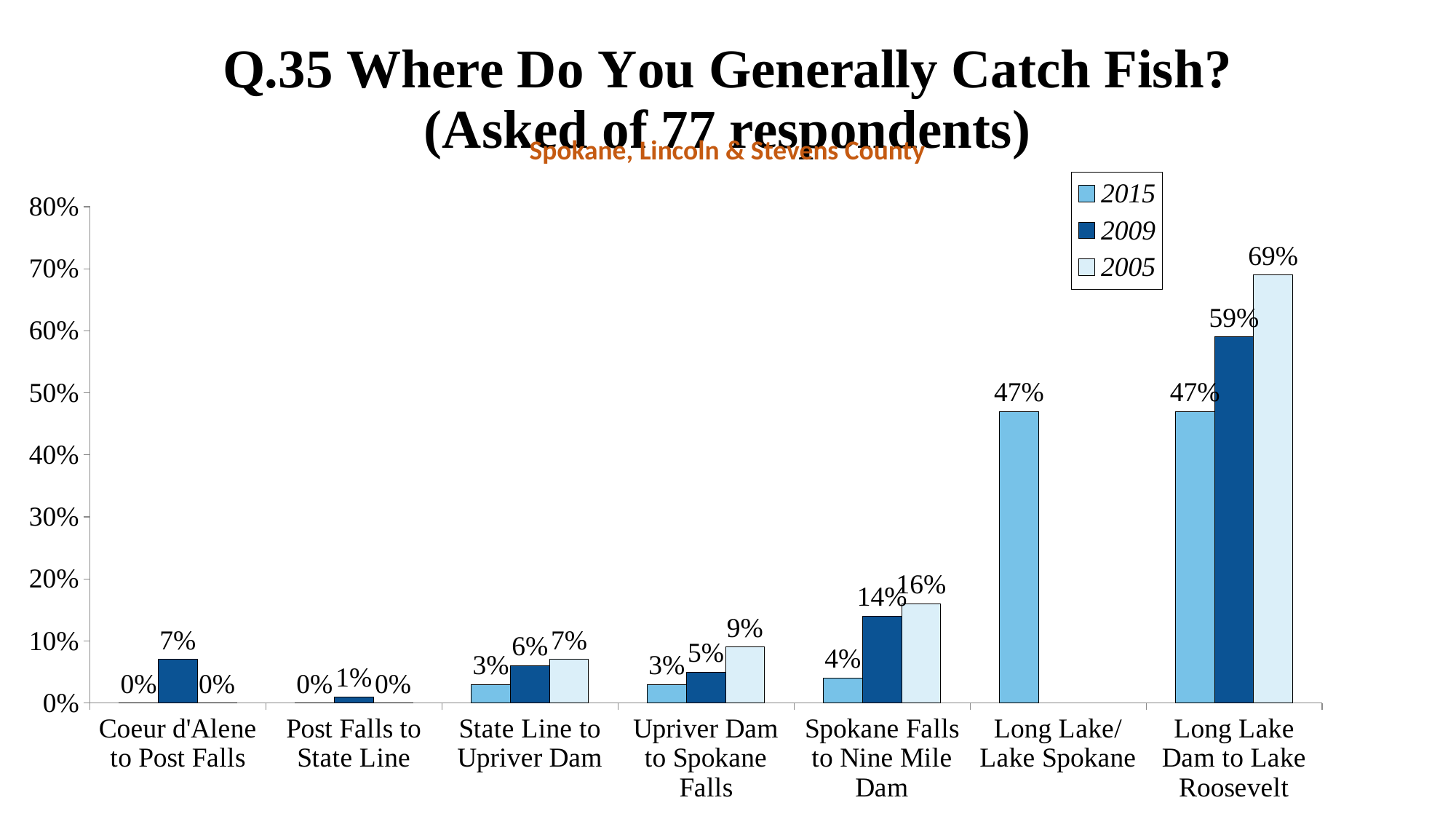
What is the difference between the 2005 and 2015 values for Long Lake Dam to Lake Roosevelt? 22% How many categories are shown on the x axis? 7 What kind of chart is shown on the slide? bar chart Which years are listed in the legend? 2015, 2009, 2005 What is the 2009 value for Spokane Falls to Nine Mile Dam? 14% Which category has the highest 2009 value? Long Lake Dam to Lake Roosevelt Is the 2009 value for Long Lake Dam to Lake Roosevelt greater or less than 50%? greater What is the 2005 value for Long Lake Dam to Lake Roosevelt? 69% What is the 2015 value for Long Lake/Lake Spokane? 47% Which is larger: the 2005 value for Upriver Dam to Spokane Falls or the 2005 value for State Line to Upriver Dam? Upriver Dam to Spokane Falls How many series does the legend list? 3 What is the 2009 value for Coeur d'Alene to Post Falls? 7%